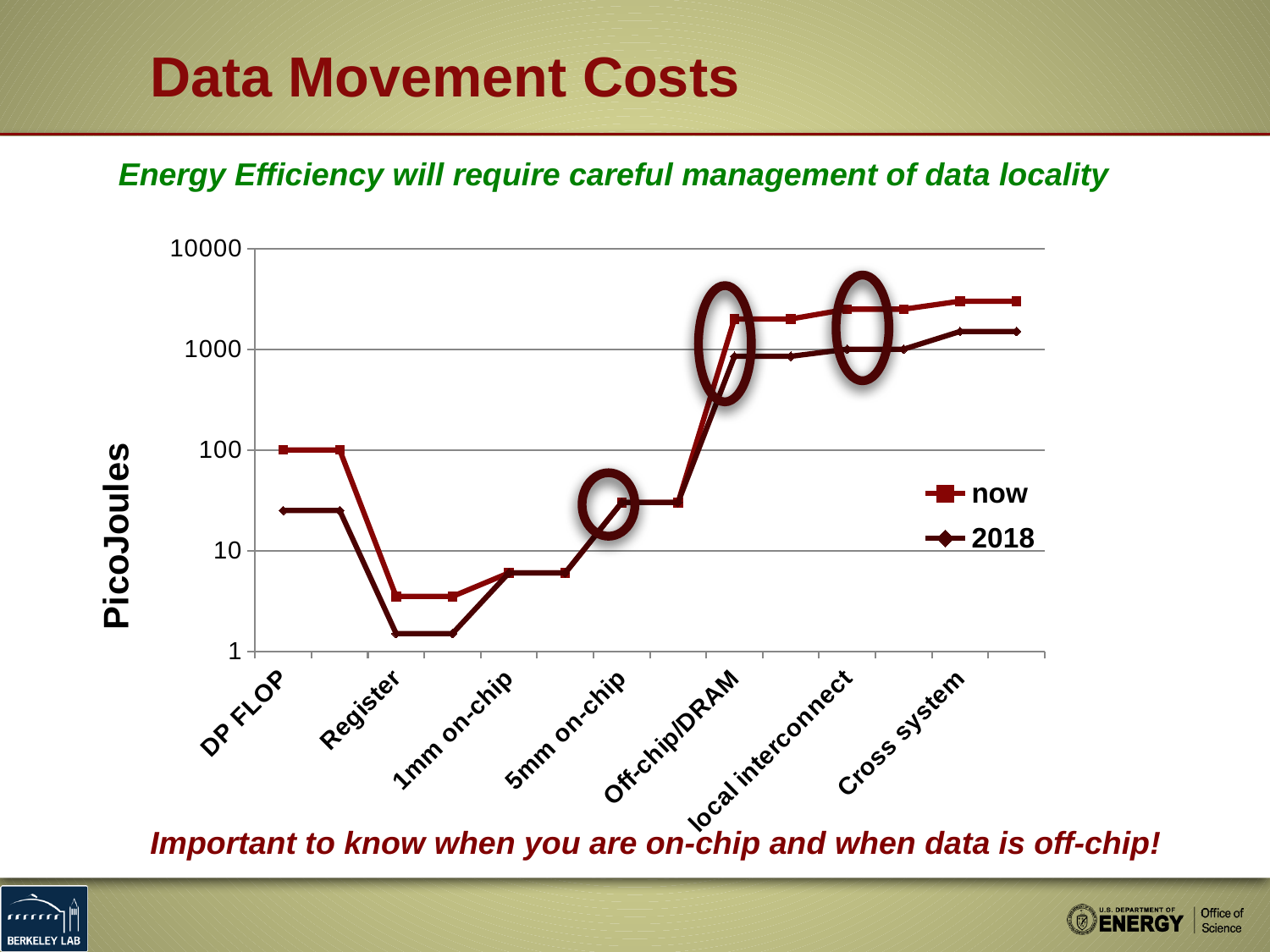
Is the value for 'now' at 5mm on-chip greater or less than 10? greater At Cross system, which series has the higher value, 'now' or '2018'? now What kind of chart is shown on the slide? line chart How many series does the legend list? 2 What are the two series named in the legend? now and 2018 Is the value for 'now' at Off-chip/DRAM greater or less than 1000? greater What is the label on the y axis? PicoJoules Is the value for '2018' at DP FLOP greater or less than 100? less What is the value for 'now' at DP FLOP? 100 For the 'now' series, which category has the lowest value? Register